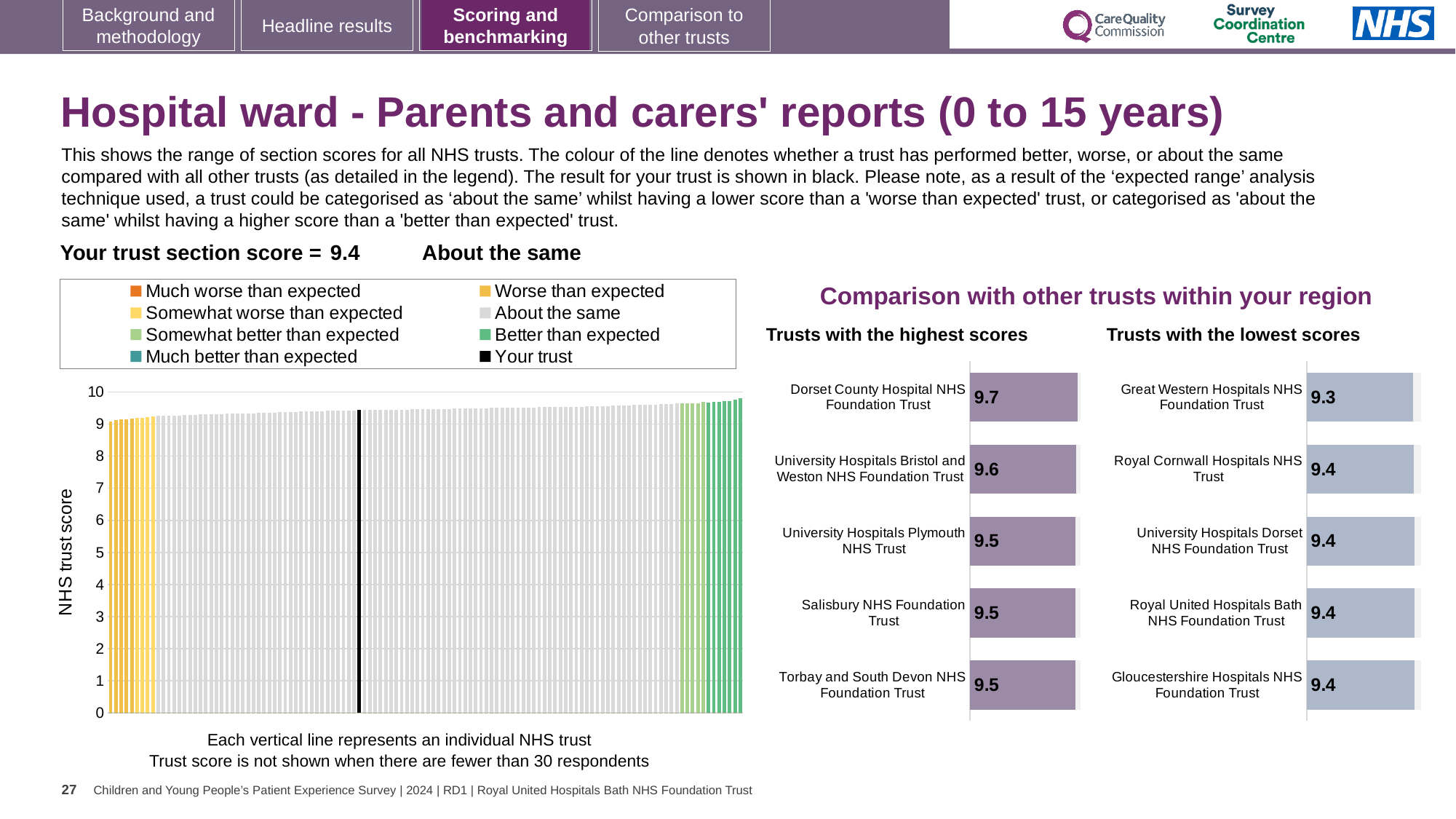
How many entries does the legend above the large chart on the left list? 8 In the large chart on the left, is the value for 'Your trust' (the black line) greater or less than 5? greater In the 'Trusts with the highest scores' chart, what is the difference between the scores of Dorset County Hospital NHS Foundation Trust and University Hospitals Bristol and Weston NHS Foundation Trust? 0.1 In the 'Trusts with the highest scores' chart, what is the score for University Hospitals Bristol and Weston NHS Foundation Trust? 9.6 Which is larger: the score for Dorset County Hospital NHS Foundation Trust in the highest scores chart, or the score for Great Western Hospitals NHS Foundation Trust in the lowest scores chart? Dorset County Hospital NHS Foundation Trust How many trusts are listed in the 'Trusts with the lowest scores' chart? 5 In the 'Trusts with the highest scores' chart, which trust has the highest score? Dorset County Hospital NHS Foundation Trust In the 'Trusts with the lowest scores' chart, which trust has the lowest score? Great Western Hospitals NHS Foundation Trust What type of chart is the large chart on the left with the 'NHS trust score' axis? bar chart In the 'Trusts with the highest scores' chart, what is the score for Dorset County Hospital NHS Foundation Trust? 9.7 In the 'Trusts with the lowest scores' chart, what is the score for Great Western Hospitals NHS Foundation Trust? 9.3 In the 'Trusts with the lowest scores' chart, what is the score for Gloucestershire Hospitals NHS Foundation Trust? 9.4